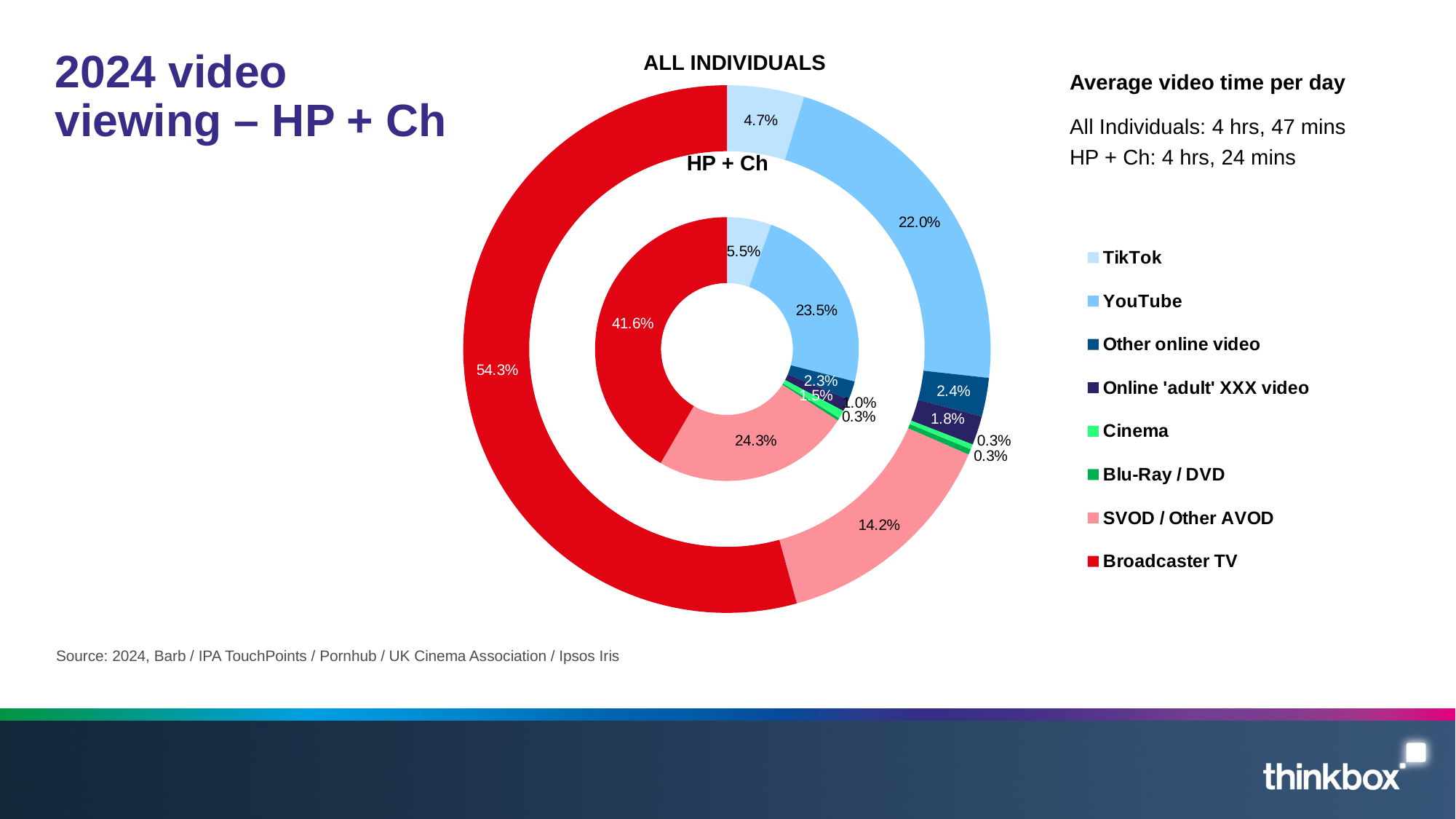
What share of video viewing does Broadcaster TV account for in the HP + Ch (inner) ring? 41.6% Which is larger: the SVOD / Other AVOD share for HP + Ch or for ALL INDIVIDUALS? HP + Ch What share of video viewing does Broadcaster TV account for in the ALL INDIVIDUALS (outer) ring? 54.3% What is the difference between the Broadcaster TV share for ALL INDIVIDUALS and for HP + Ch? 12.7 percentage points How many categories does the legend list? 8 What is the difference between the YouTube share for HP + Ch and for ALL INDIVIDUALS? 1.5 percentage points Which colour represents Broadcaster TV in the chart? Red What is the TikTok share in the HP + Ch ring? 5.5% What is the SVOD / Other AVOD share in the HP + Ch ring? 24.3% Which category has the largest share in the ALL INDIVIDUALS ring? Broadcaster TV What kind of chart is shown on the slide? Doughnut chart What is the YouTube share in the ALL INDIVIDUALS ring? 22.0%